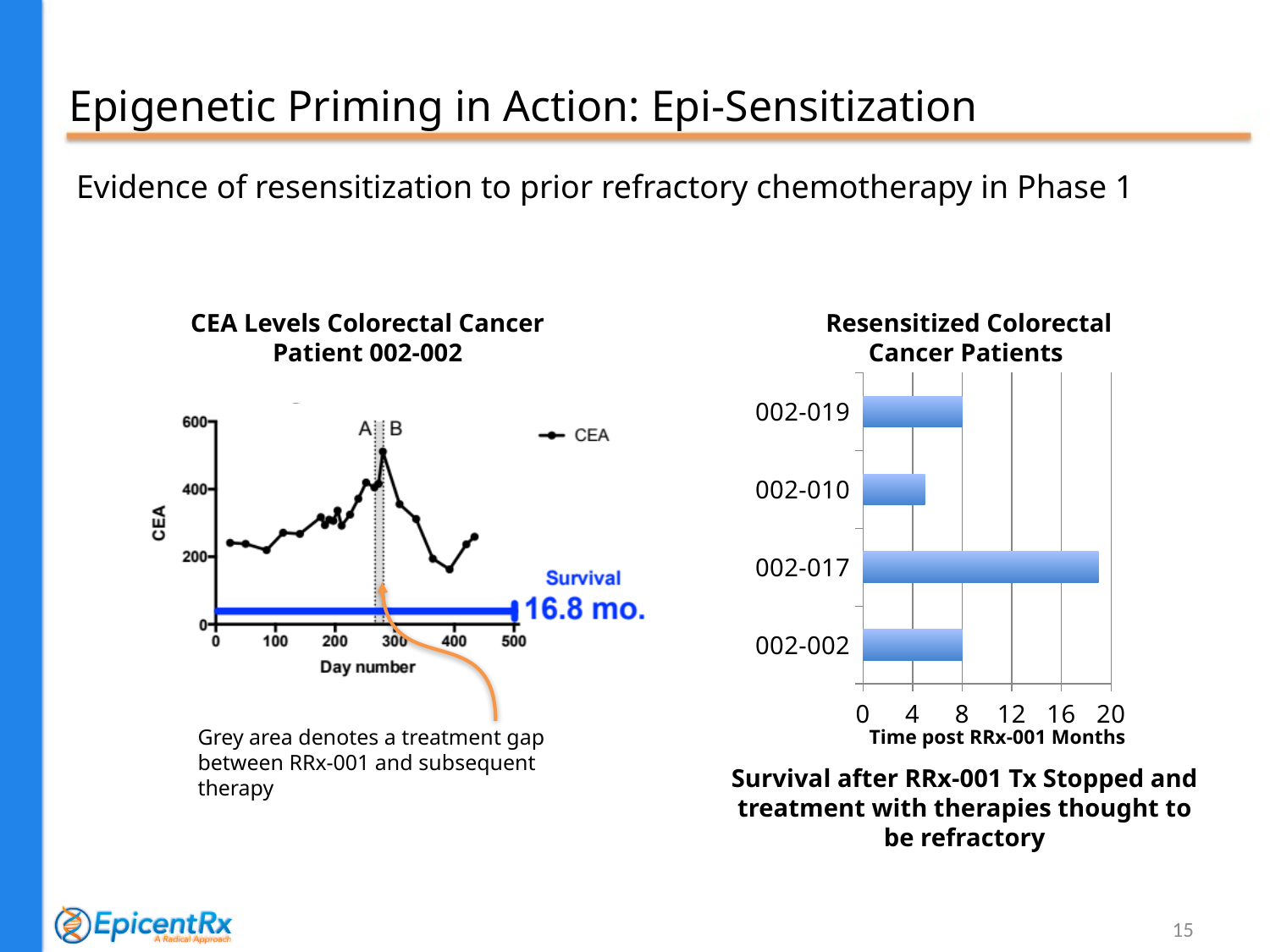
In the 'Resensitized Colorectal Cancer Patients' chart, is the value for 002-010 greater or less than 8? less What survival duration is printed on the 'CEA Levels Colorectal Cancer Patient 002-002' chart? 16.8 mo. In the 'Resensitized Colorectal Cancer Patients' chart, which patient has the longest time post RRx-001? 002-017 What kind of chart is the 'CEA Levels Colorectal Cancer Patient 002-002' chart? line chart How many series does the legend of the 'CEA Levels Colorectal Cancer Patient 002-002' chart list? 1 In the 'Resensitized Colorectal Cancer Patients' chart, which is larger, the value for 002-017 or the value for 002-002? 002-017 How many patients are shown in the 'Resensitized Colorectal Cancer Patients' chart? 4 What kind of chart is the 'Resensitized Colorectal Cancer Patients' chart? bar chart In the 'Resensitized Colorectal Cancer Patients' chart, which patient has the shortest time post RRx-001? 002-010 In the 'CEA Levels Colorectal Cancer Patient 002-002' chart, is the highest CEA value greater or less than 400? greater In the 'Resensitized Colorectal Cancer Patients' chart, is the value for 002-017 greater or less than 16? greater What is the x-axis title of the 'Resensitized Colorectal Cancer Patients' chart? Time post RRx-001 Months